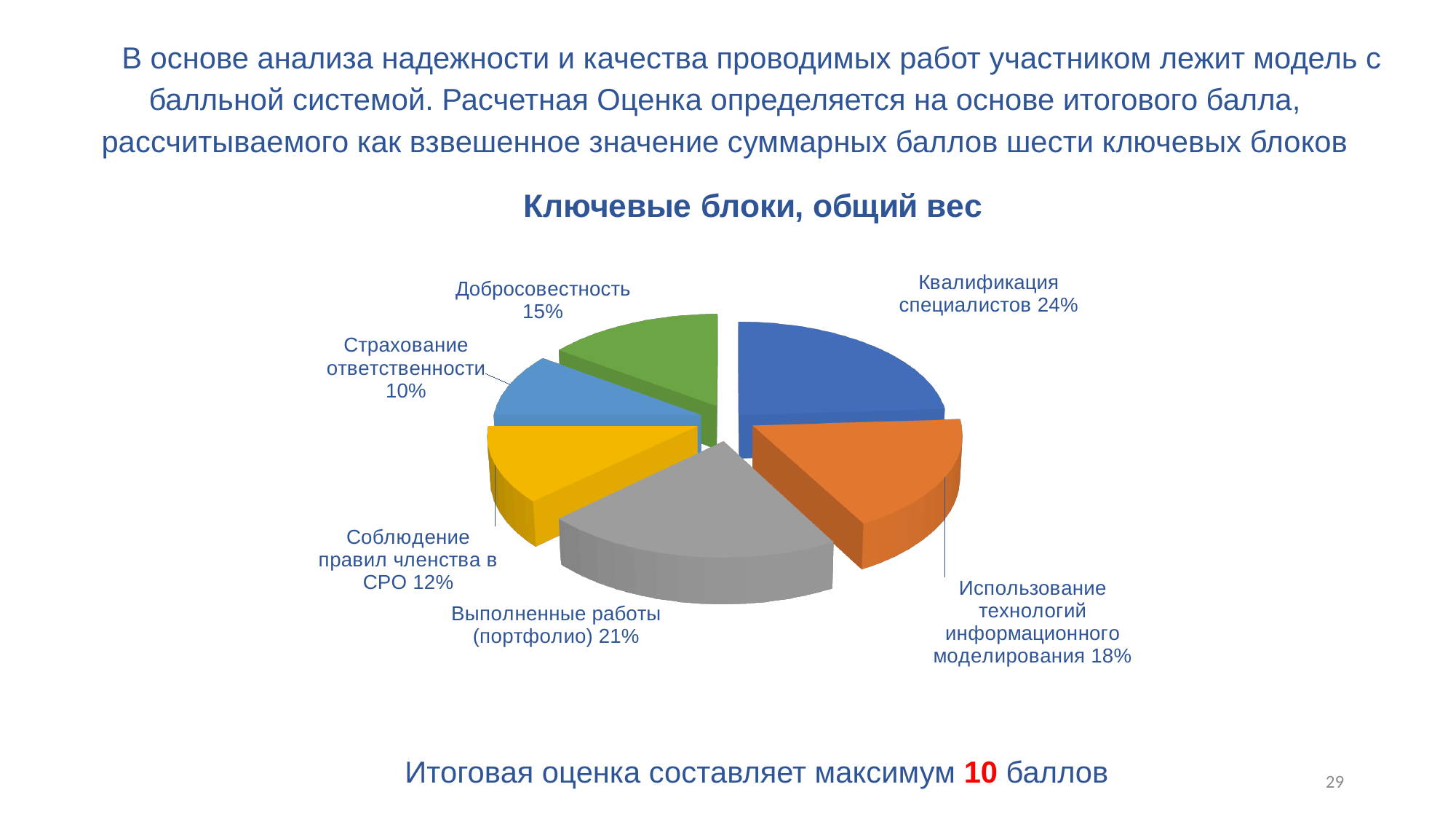
What is the share for Выполненные работы (портфолио)? 21% What colour is the slice for Квалификация специалистов? Blue Which block has the smallest share? Страхование ответственности Which block has the largest share? Квалификация специалистов Which is larger: the share for Выполненные работы (портфолио) or the share for Добросовестность? Выполненные работы (портфолио) What is the chart's title? Ключевые блоки, общий вес What is the share for Использование технологий информационного моделирования? 18% How many slices does the pie chart have? 6 What is the share for Страхование ответственности? 10% What is the share for Квалификация специалистов? 24% What kind of chart is shown on the slide? Pie chart What is the difference between the shares of Добросовестность and Соблюдение правил членства в СРО? 3%